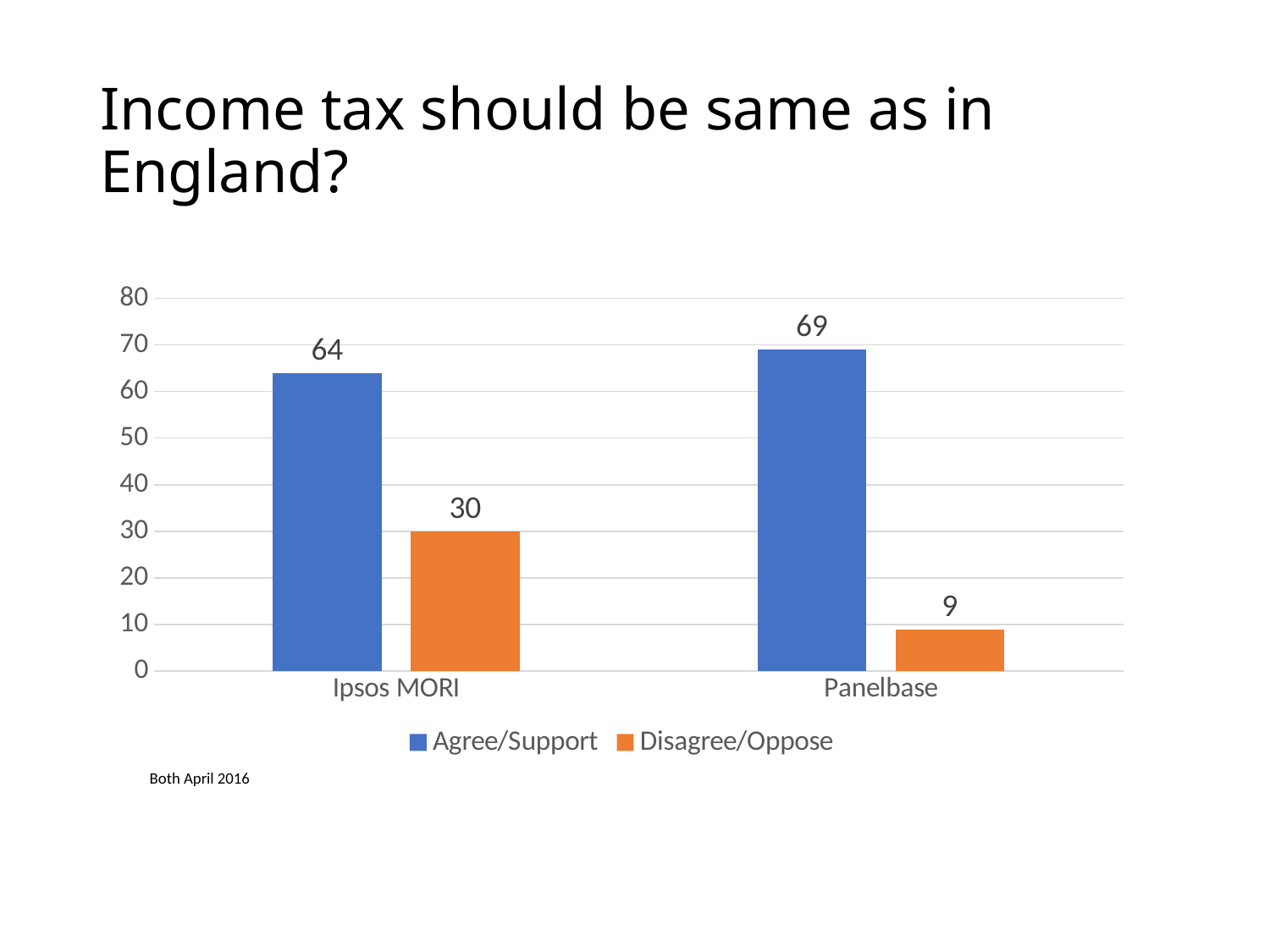
Which poll has the higher Agree/Support value? Panelbase Which poll has the lower Disagree/Oppose value? Panelbase Is the Disagree/Oppose value for Ipsos MORI larger or smaller than the Disagree/Oppose value for Panelbase? larger What kind of chart is shown on the slide? bar chart What is the Disagree/Oppose value for Panelbase? 9 How many series does the legend list? 2 How many polls are shown on the x axis? 2 What is the Agree/Support value for Panelbase? 69 What is the difference between the Agree/Support and Disagree/Oppose values for Ipsos MORI? 34 What is the Disagree/Oppose value for Ipsos MORI? 30 What is the difference between the Agree/Support values for Panelbase and Ipsos MORI? 5 What is the Agree/Support value for Ipsos MORI? 64